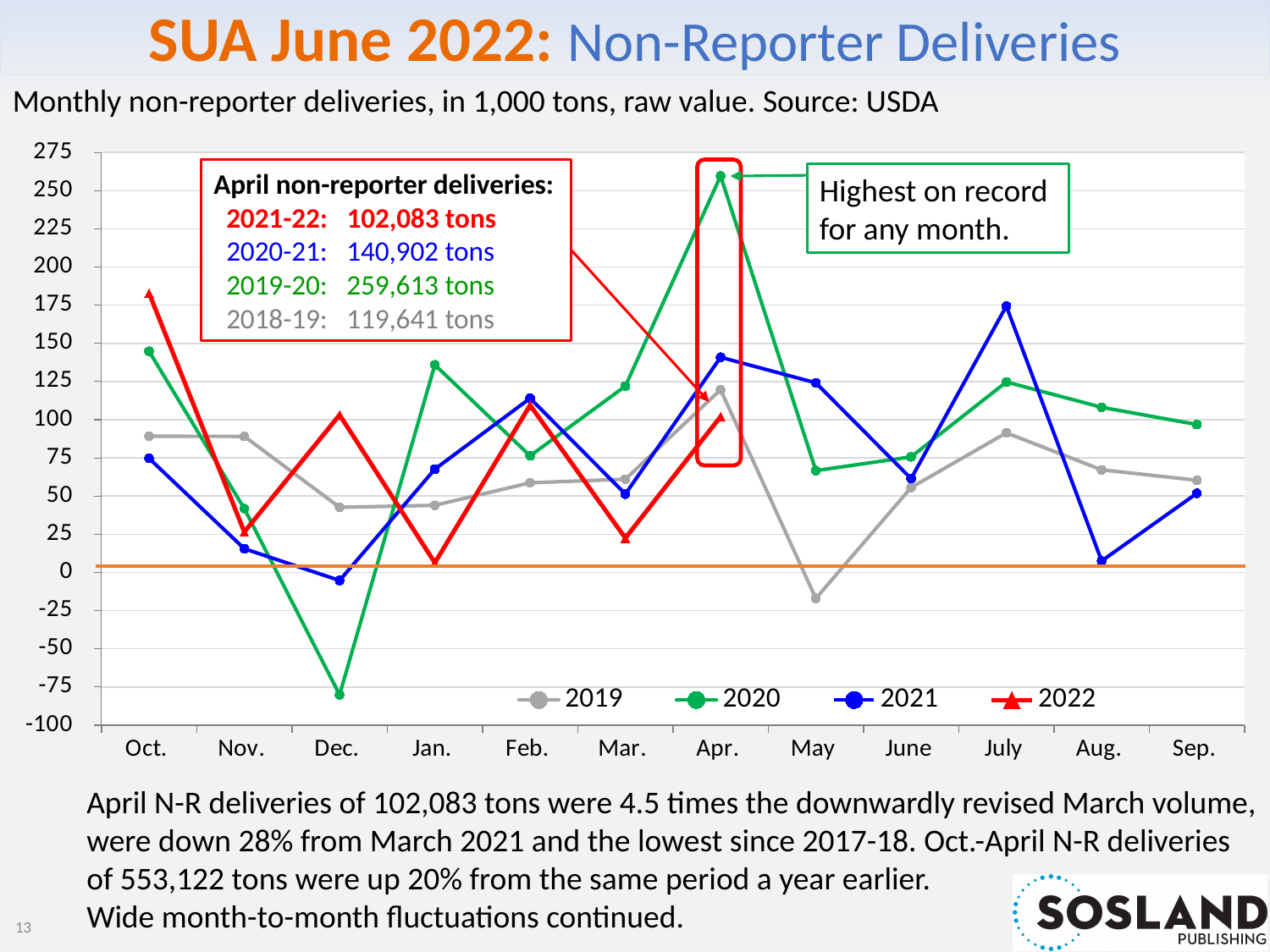
According to the annotation box, what were April non-reporter deliveries in 2021-22? 102,083 tons Which series reaches the highest point on the chart? 2020 In which month does the 2020 series reach its lowest value? Dec. Does the 2020 series rise or fall from Apr. to May? fall In Oct., which series has the higher value, 2022 or 2019? 2022 According to the annotation box, what were April non-reporter deliveries in 2019-20? 259,613 tons Is the value for the 2021 series in July greater or less than 150? greater What type of chart is shown on the slide? line chart What does the green annotation box say about the April 2020 point? Highest on record for any month. How many months are shown along the x axis? 12 How many series does the legend list? 4 Using the annotation box, what is the difference between April deliveries in 2019-20 and 2020-21? 118,711 tons